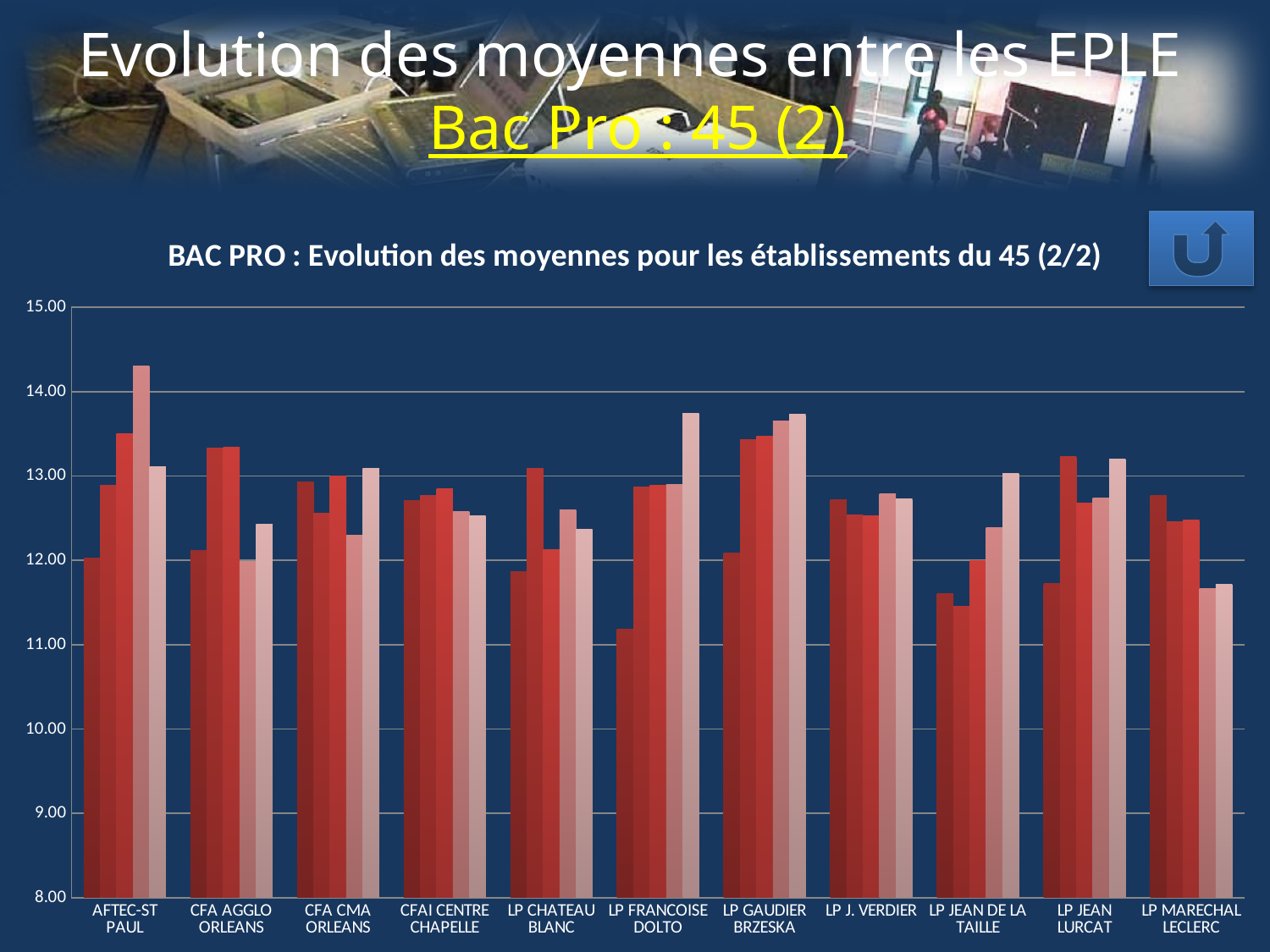
How many bars are plotted for each establishment in the chart? 5 Is the tallest bar for AFTEC-ST PAUL greater or less than 14.00? greater What kind of chart is shown on the slide? bar chart Is the first (leftmost) bar for LP JEAN DE LA TAILLE greater or less than 12.00? less How many establishments (categories) are shown on the x axis of the chart? 11 Is the first (leftmost) bar for LP FRANCOISE DOLTO greater or less than 12.00? less What is the title of the chart? BAC PRO : Evolution des moyennes pour les établissements du 45 (2/2) Which establishment has the single shortest bar in the chart? LP FRANCOISE DOLTO Which establishment has the single tallest bar in the chart? AFTEC-ST PAUL What is the highest value shown on the chart's vertical axis? 15.00 Which is taller: the tallest bar for LP GAUDIER BRZESKA or the tallest bar for LP MARECHAL LECLERC? LP GAUDIER BRZESKA